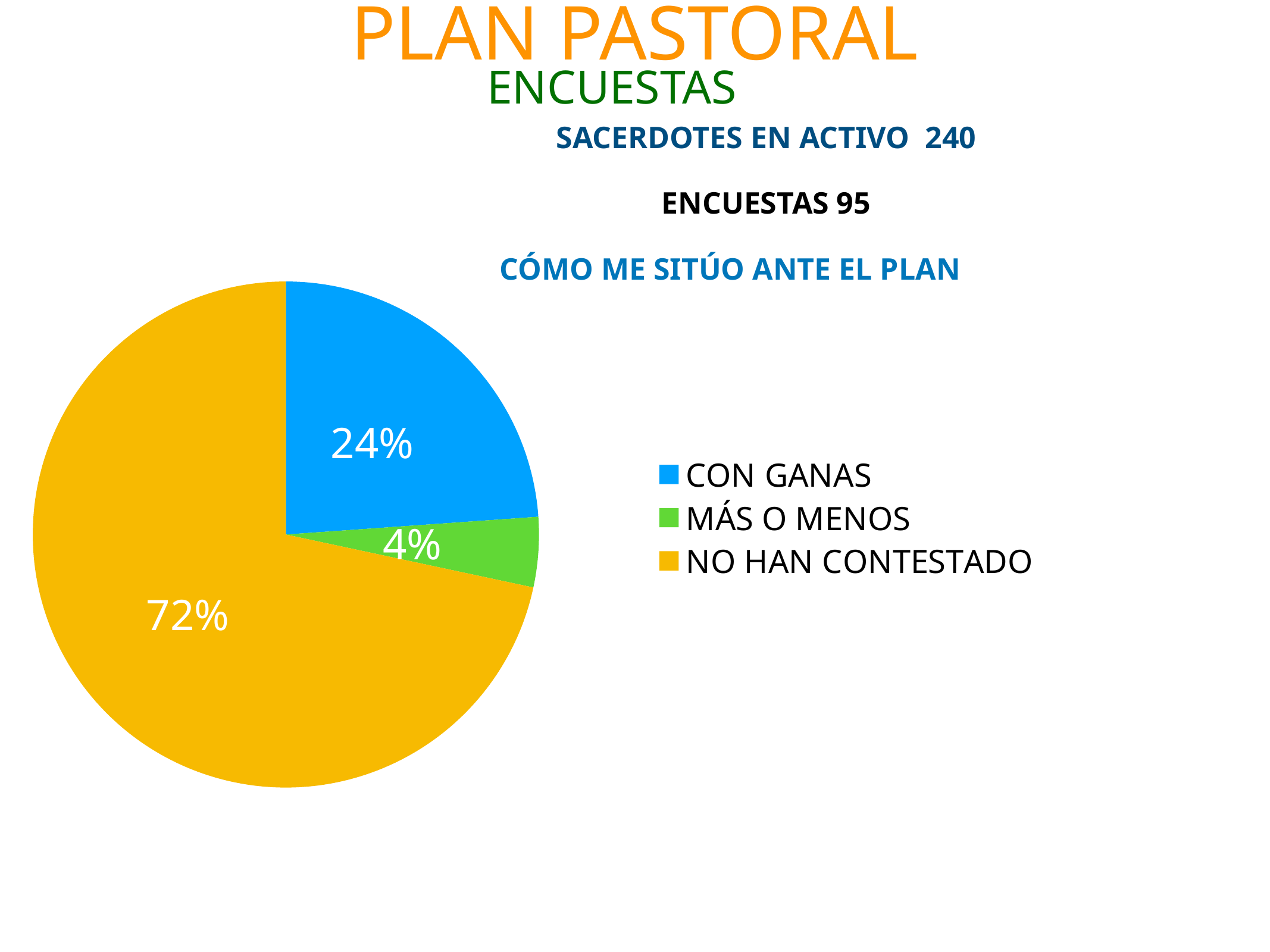
What percentage of the pie is labelled MÁS O MENOS? 4% Which category has the smallest slice of the pie? MÁS O MENOS How many slices does the pie chart have? 3 What colour is the slice for NO HAN CONTESTADO? yellow What percentage of the pie is labelled NO HAN CONTESTADO? 72% What is the title shown above the pie chart? CÓMO ME SITÚO ANTE EL PLAN What is the difference in percentage points between NO HAN CONTESTADO and CON GANAS? 48 What kind of chart is shown on the slide? pie chart Which is larger, the slice for CON GANAS or the slice for MÁS O MENOS? CON GANAS Which category has the largest slice of the pie? NO HAN CONTESTADO What is the difference in percentage points between CON GANAS and MÁS O MENOS? 20 What percentage of the pie is labelled CON GANAS? 24%